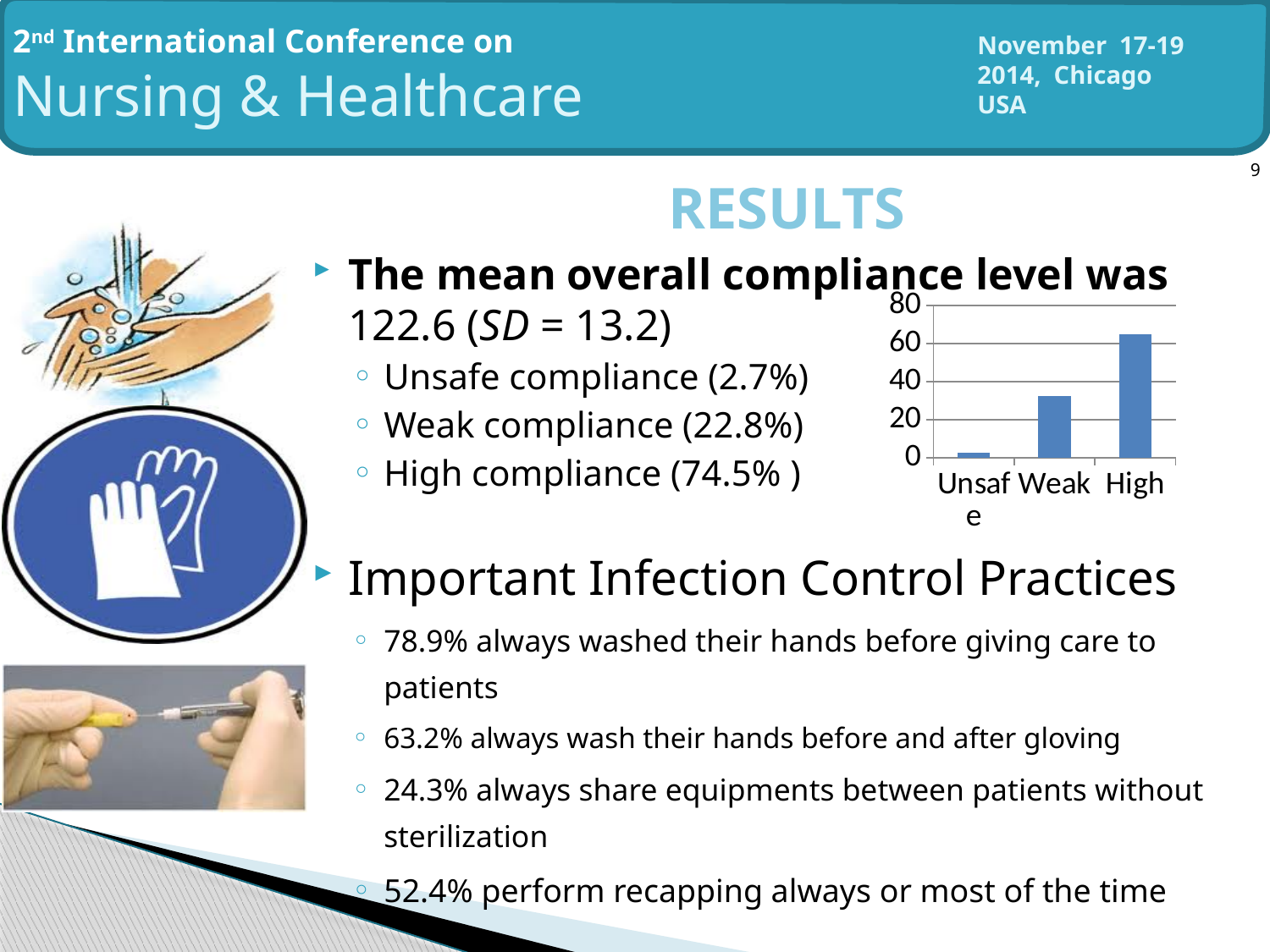
Is the value for High greater or less than 80? less Do the bar values rise or fall from left to right along the x axis? rise Is the value for Weak greater or less than 40? less What kind of chart is shown on the slide? bar chart Is the value for Weak greater or less than 20? greater Which is larger in the chart, the value for Weak or the value for High? High How many categories are shown on the x axis of the chart? 3 Which category has the highest bar in the chart? High What is the highest tick value shown on the chart's vertical axis? 80 Which category has the lowest bar in the chart? Unsafe